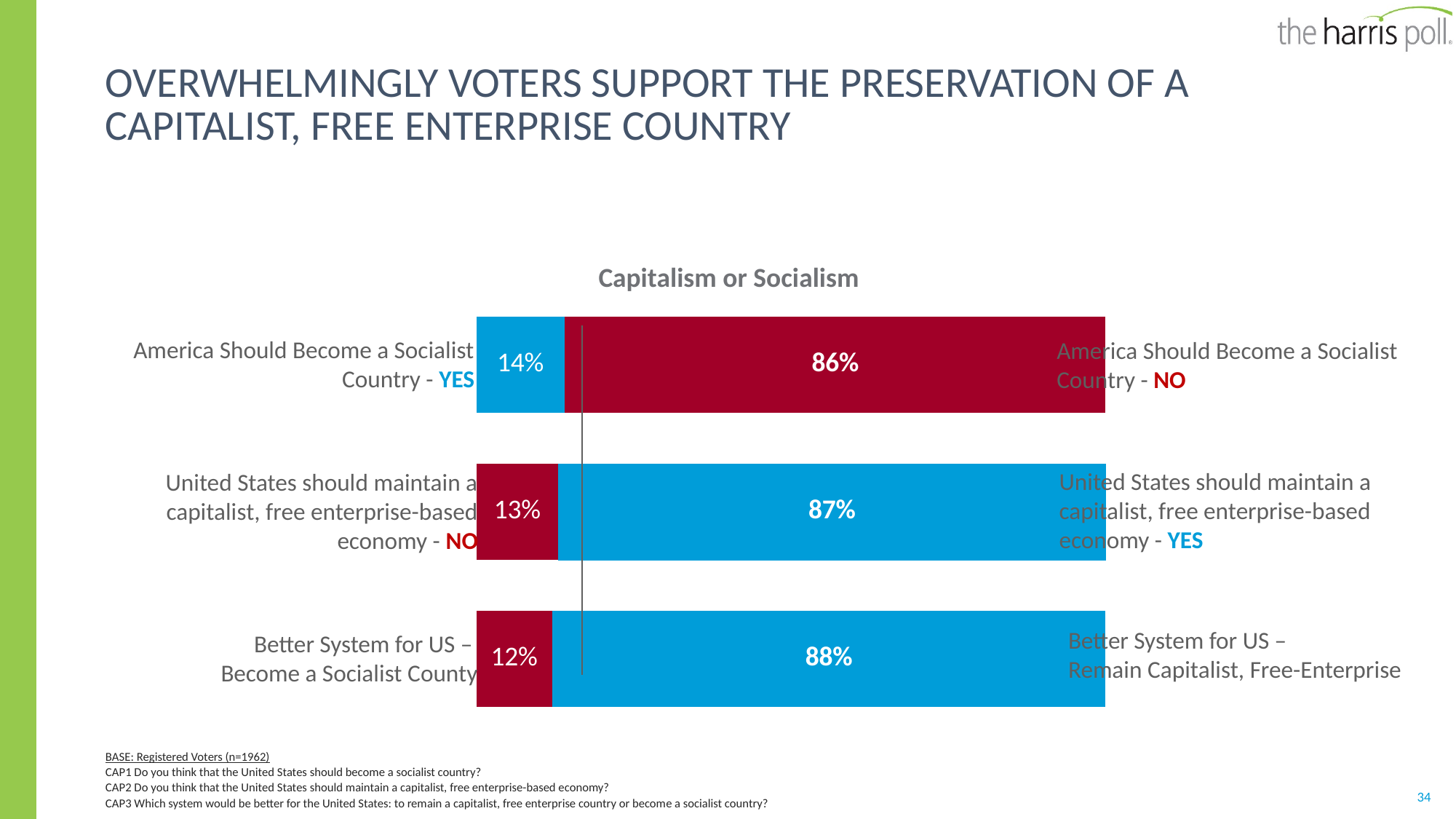
What percentage say the United States should maintain a capitalist, free enterprise-based economy - NO? 13% What percentage of voters say America should become a socialist country - YES? 14% What percentage say the United States should maintain a capitalist, free enterprise-based economy - YES? 87% What is the total of the two segments in the 'Better System for US' bar? 100% What percentage of voters say America should become a socialist country - NO? 86% How many bars (rows) does the chart show? 3 What is the difference between the share saying NO and the share saying YES to America becoming a socialist country? 72% Which is larger: the share saying the better system is to remain capitalist, free-enterprise, or the share saying the better system is to become a socialist country? Remain capitalist, free-enterprise What percentage say the better system for the US is to remain capitalist, free-enterprise? 88% What percentage say the better system for the US is to become a socialist country? 12% What is the title of the chart? Capitalism or Socialism What kind of chart is shown on the slide? Bar chart